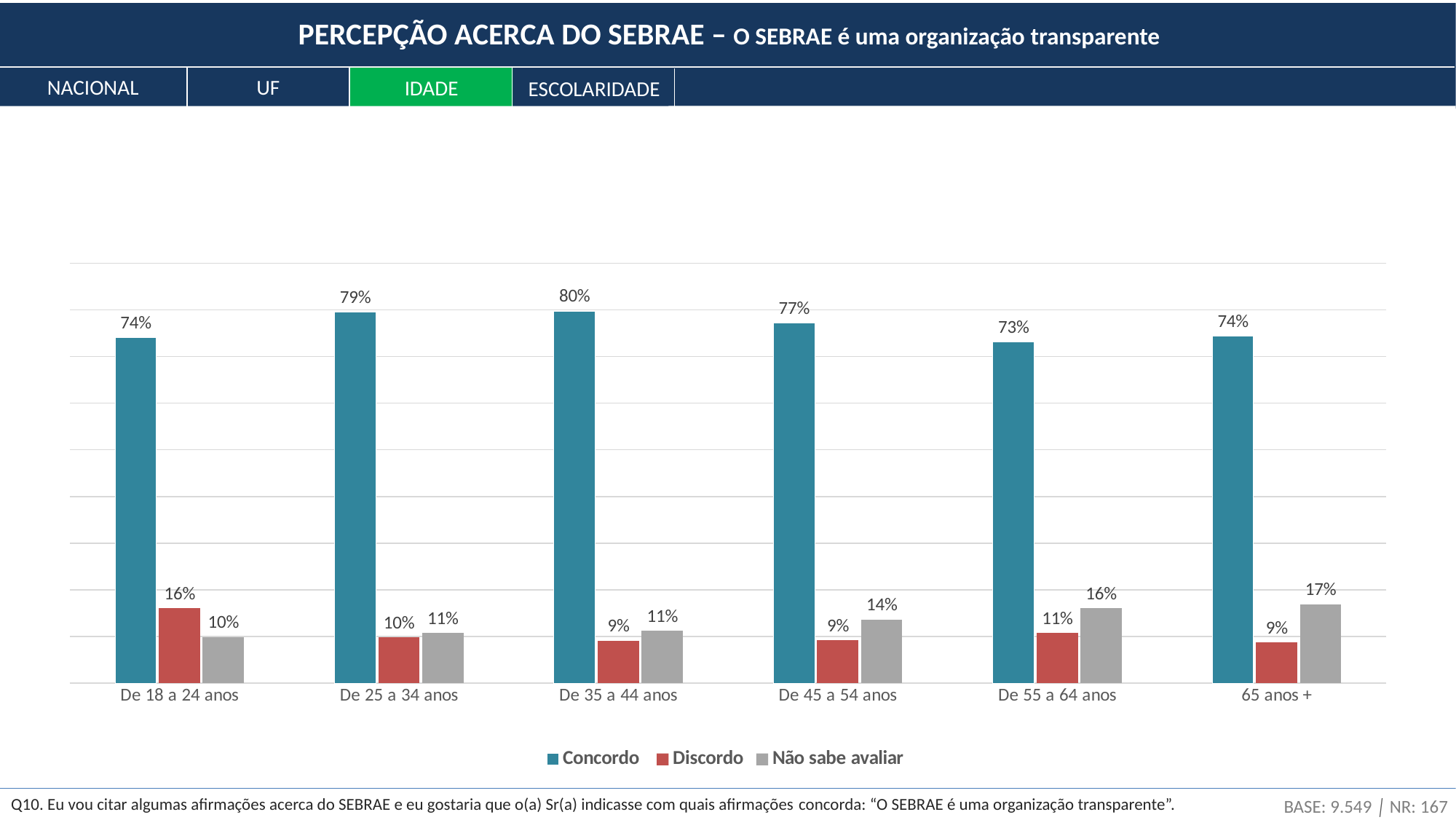
What kind of chart is shown on the slide? Bar chart What is the Concordo value for De 35 a 44 anos? 80% How many series does the legend list? 3 Which age group has the highest Concordo value? De 35 a 44 anos What is the difference between the Concordo values for De 35 a 44 anos and De 55 a 64 anos? 7% Which age group has the lowest Concordo value? De 55 a 64 anos What is the Não sabe avaliar value for 65 anos +? 17% Which age group has the highest Discordo value? De 18 a 24 anos Which is larger for De 45 a 54 anos: Discordo or Não sabe avaliar? Não sabe avaliar Which tab is highlighted in green at the top of the slide? IDADE What is the Discordo value for De 18 a 24 anos? 16% How many age groups are shown on the x axis? 6